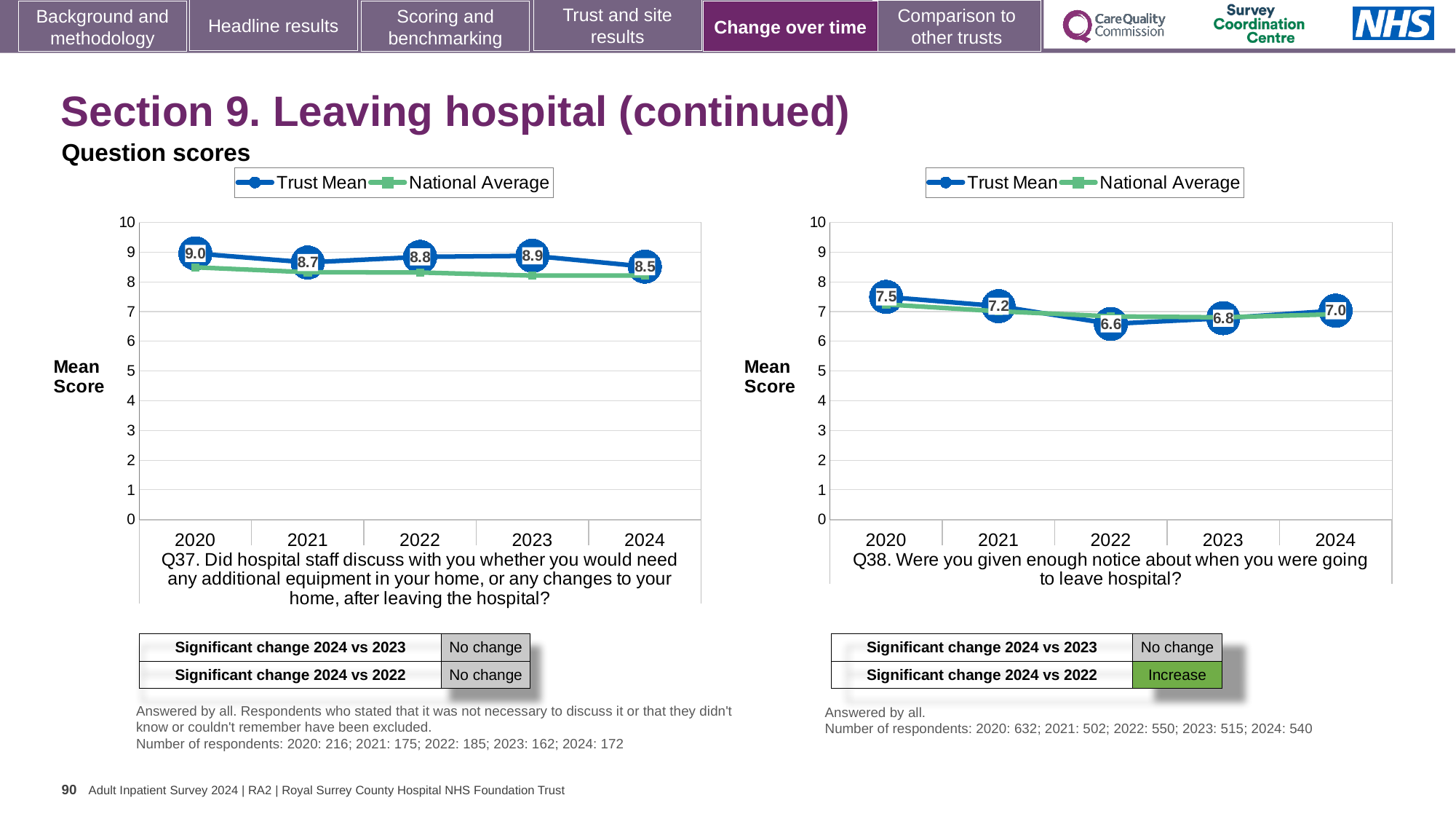
In the Q38 chart on the right, which year has the lowest Trust Mean score? 2022 What type of chart is used for the Q37 chart on the left? Line chart In the Q38 chart on the right, what is the difference between the Trust Mean scores for 2020 and 2022? 0.9 In the Q37 chart on the left, is the Trust Mean score for 2023 higher or lower than for 2021? higher In the Q38 chart on the right, what is the Trust Mean score for 2024? 7.0 In the Q37 chart on the left, what is the Trust Mean score for 2020? 9.0 In the Q38 chart on the right, what is the Trust Mean score for 2022? 6.6 In the Q37 chart on the left, what is the Trust Mean score for 2024? 8.5 In the Q37 chart on the left, which year has the highest Trust Mean score? 2020 How many series does the legend of the Q38 chart on the right list? 2 How many years are plotted on the x axis of the Q37 chart on the left? 5 In the Q38 chart on the right, is the National Average for 2020 greater or less than 6? greater